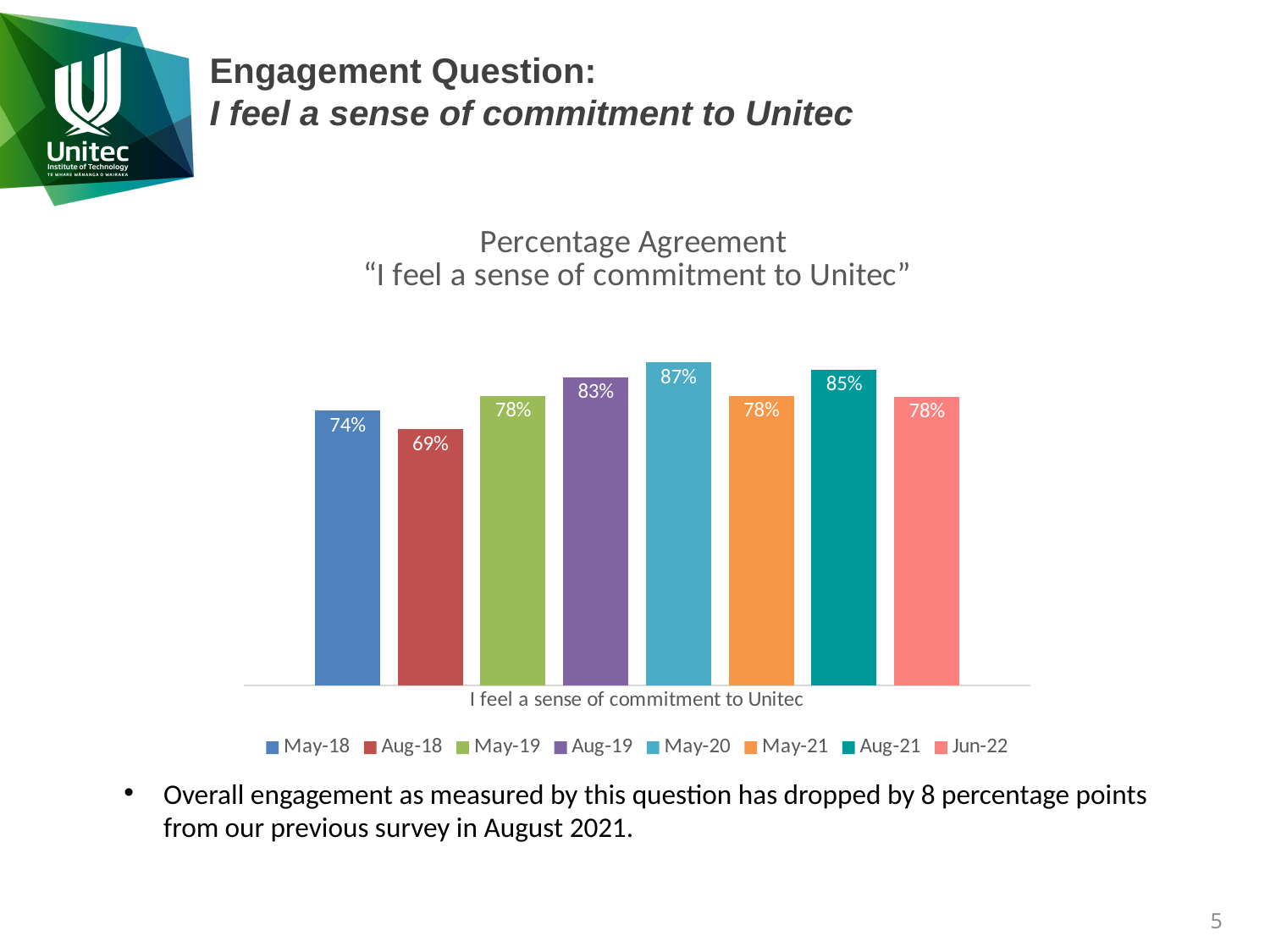
What is the value for May-18? 74% Which series has the lowest value? Aug-18 What is the value for May-20? 87% What is the value for Aug-18? 69% What is the difference between the Aug-21 value and the Jun-22 value? 7% What is the difference between the May-20 value and the Aug-18 value? 18% What is the value for Jun-22? 78% Which is larger, the value for Aug-19 or the value for May-19? Aug-19 How many series does the legend list? 8 What kind of chart is shown? bar chart What is the title of the chart? Percentage Agreement "I feel a sense of commitment to Unitec" Which series has the highest value? May-20